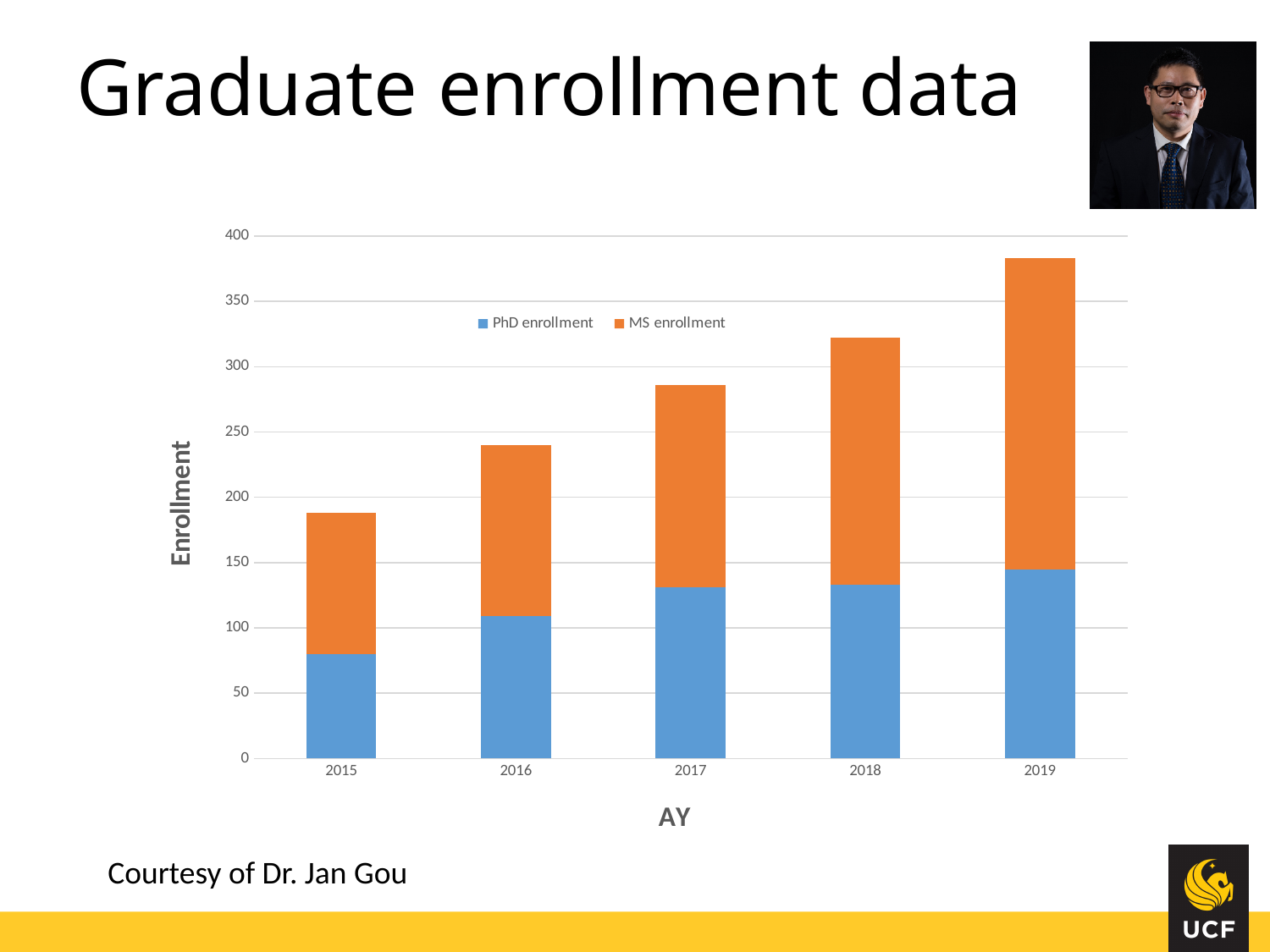
Is the PhD enrollment for 2015 greater or less than 100? less Does total enrollment rise or fall from 2015 to 2019? Rises Is the total enrollment for 2019 greater or less than 350? greater How many series does the legend list? 2 How many academic years are shown on the x axis? 5 What is the label on the vertical axis? Enrollment Which year has the highest total enrollment? 2019 Which year has the lowest total enrollment? 2015 What kind of chart is shown on the slide? Stacked bar chart Is the total enrollment for 2015 greater or less than 200? less Which is larger, the PhD enrollment in 2015 or in 2016? 2016